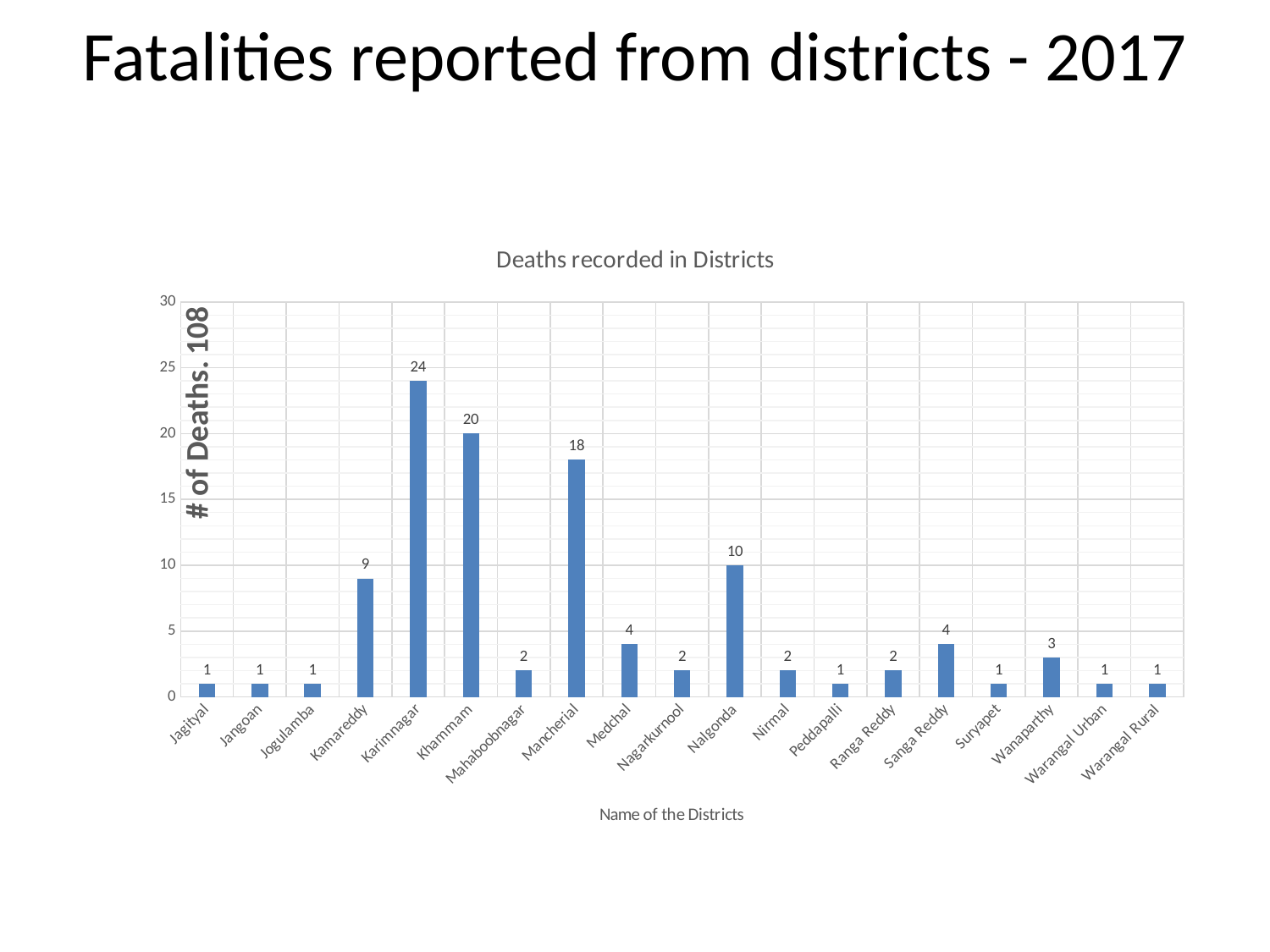
How many deaths were recorded in Karimnagar? 24 How many deaths were recorded in Nalgonda? 10 How many deaths were recorded in Mancherial? 18 What type of chart is shown on the slide? bar chart What is the label of the x axis? Name of the Districts What is the difference in deaths between Karimnagar and Khammam? 4 What is the title of the chart? Deaths recorded in Districts Which district has more deaths, Kamareddy or Nalgonda? Nalgonda How many deaths were recorded in Khammam? 20 How many deaths were recorded in Wanaparthy? 3 Which district has the highest number of deaths? Karimnagar How many districts are shown on the x axis? 19